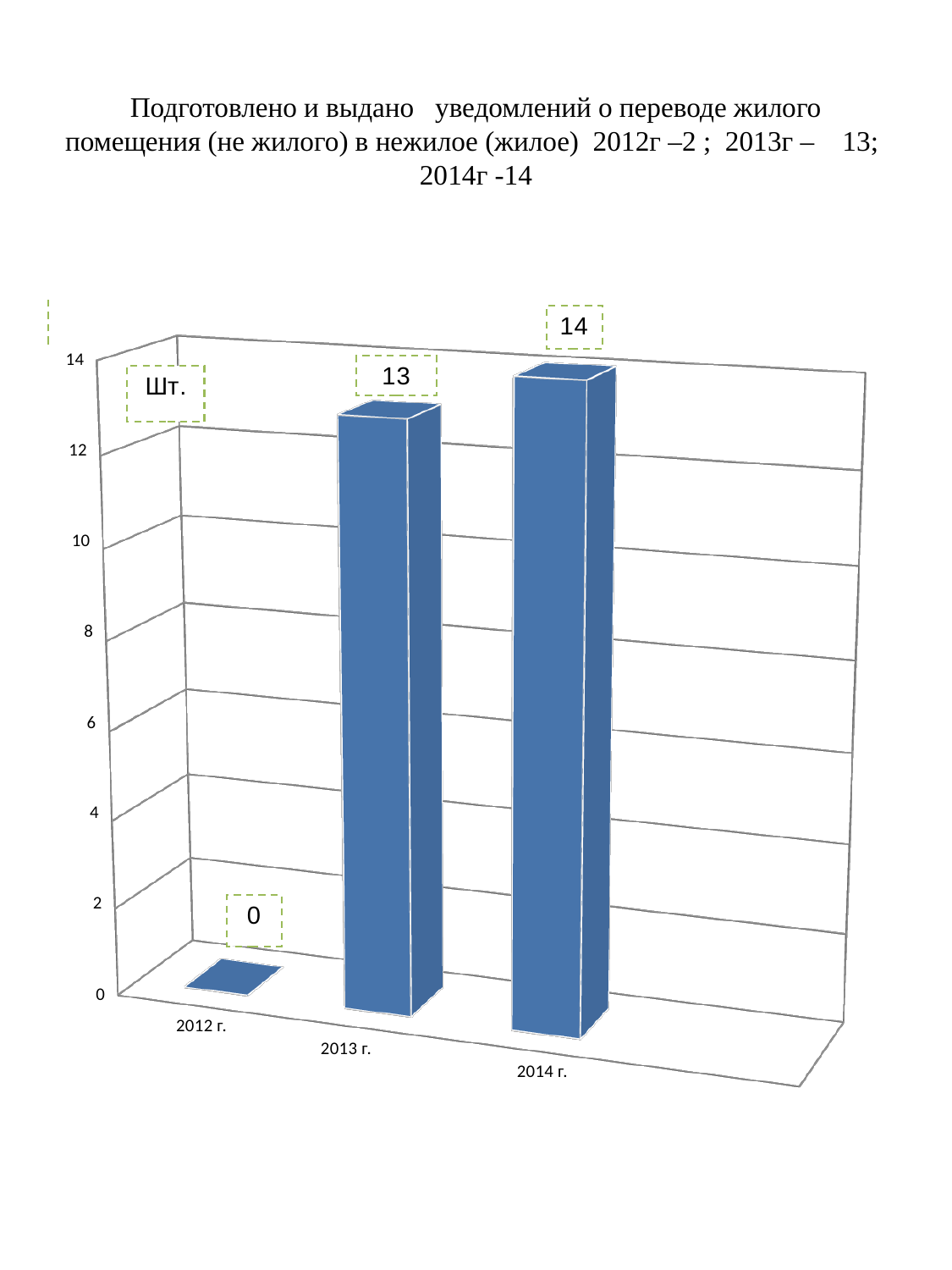
Is the value for 2013 г. greater or less than 10? greater What is the value shown by the data label for 2014 г.? 14 Which year has the lowest bar? 2012 г. What is the value shown by the data label for 2013 г.? 13 What is the difference between the values for 2014 г. and 2013 г.? 1 What is the difference between the data labels for 2013 г. and 2012 г.? 13 Which is larger, the value for 2013 г. or the value for 2014 г.? 2014 г. Do the values rise or fall from 2012 г. to 2014 г.? rise Which year has the highest bar? 2014 г. What value does the data label above the 2012 г. bar show? 0 What kind of chart is shown on the slide? bar chart How many years (categories) are shown on the chart? 3